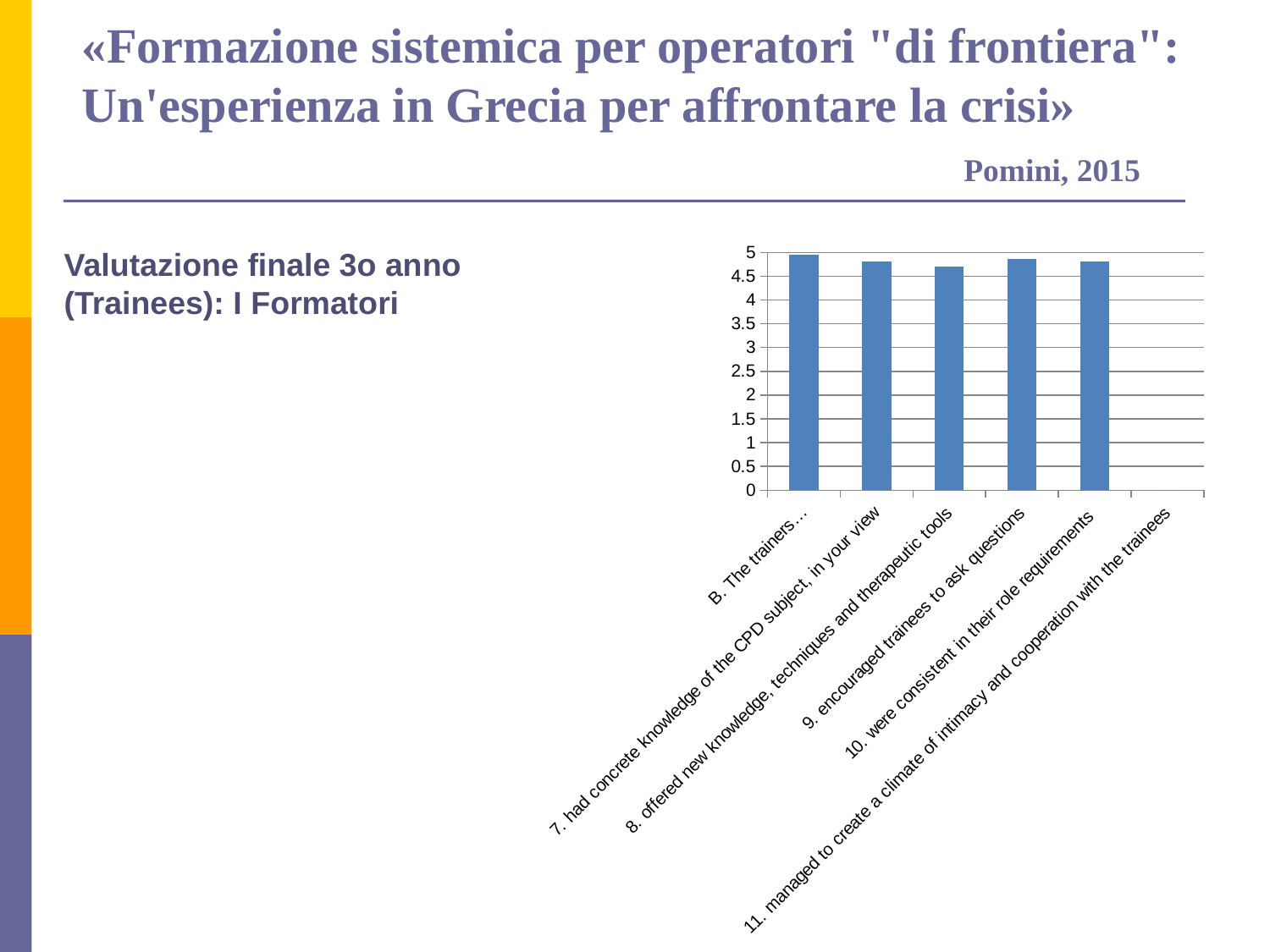
Is the value for "7. had concrete knowledge of the CPD subject, in your view" greater or less than 4.5? greater What kind of chart is shown on the slide? bar chart Which is larger, the value for "8. offered new knowledge, techniques and therapeutic tools" or for "10. were consistent in their role requirements"? 10. were consistent in their role requirements Which is larger, the value for "7. had concrete knowledge of the CPD subject, in your view" or for "8. offered new knowledge, techniques and therapeutic tools"? 7. had concrete knowledge of the CPD subject, in your view Is the value for "9. encouraged trainees to ask questions" greater or less than 4.5? greater How many bars are plotted in the chart? 5 What colour are the bars in the chart? Blue What is the highest value shown on the vertical axis of the chart? 5 Are all the bars in the chart above 4 on the vertical axis? Yes